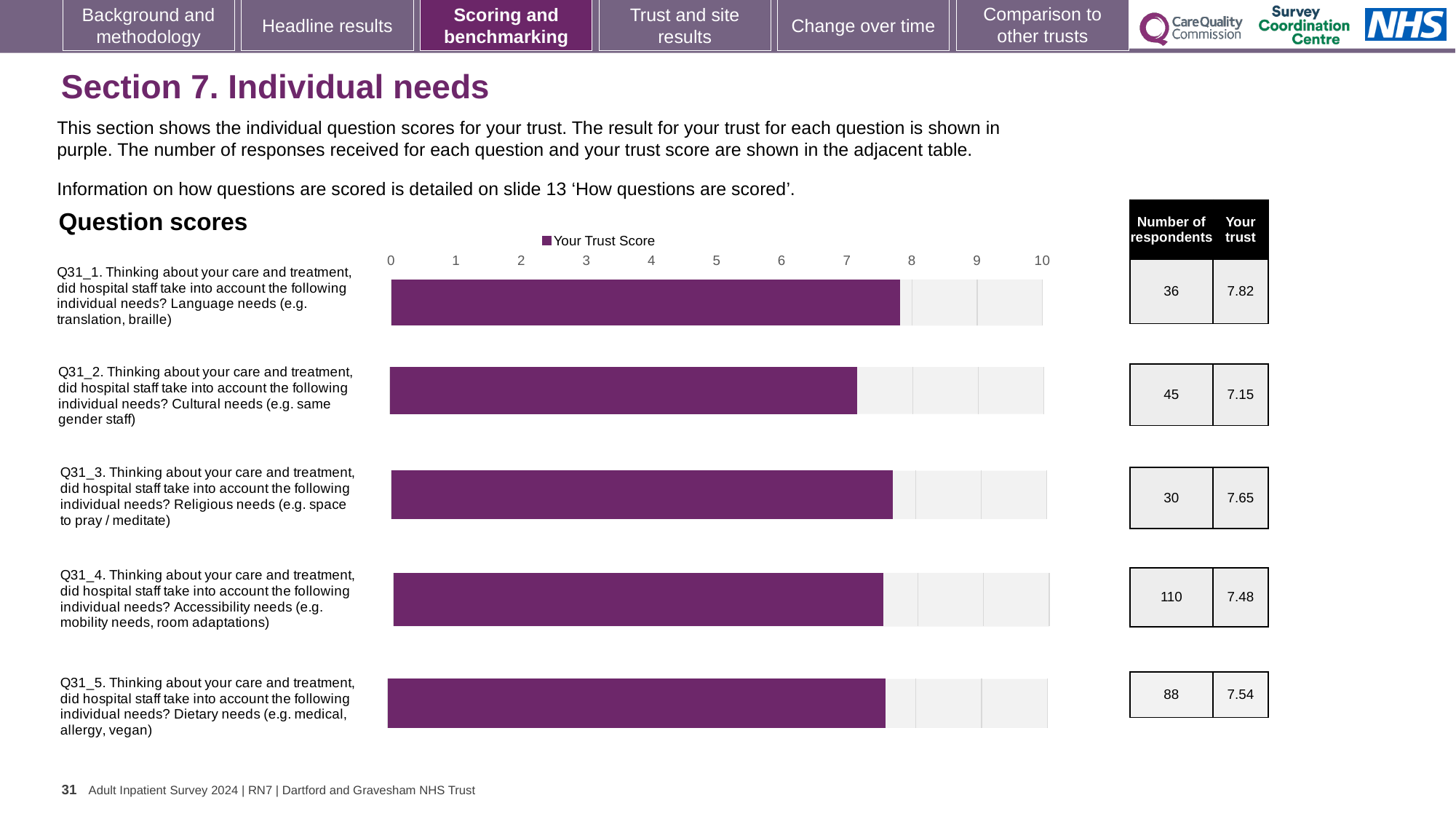
What kind of chart is used to show the question scores? Bar chart What is the legend entry shown above the charts? Your Trust Score How many respondents answered Q31_4 (Accessibility needs)? 110 How many series does the legend list? 1 What is the trust score for Q31_1 (Language needs)? 7.82 What is the trust score for Q31_2 (Cultural needs)? 7.15 Which question has the lowest trust score on this slide? Q31_2 (Cultural needs) How many questions are plotted in the Question scores charts? 5 What is the difference between the trust scores for Q31_1 and Q31_2? 0.67 Which question has the highest trust score on this slide? Q31_1 (Language needs) Is the bar for Q31_2 (Cultural needs) greater or less than 8 on the axis? less Which has the higher trust score, Q31_3 (Religious needs) or Q31_4 (Accessibility needs)? Q31_3 (Religious needs)